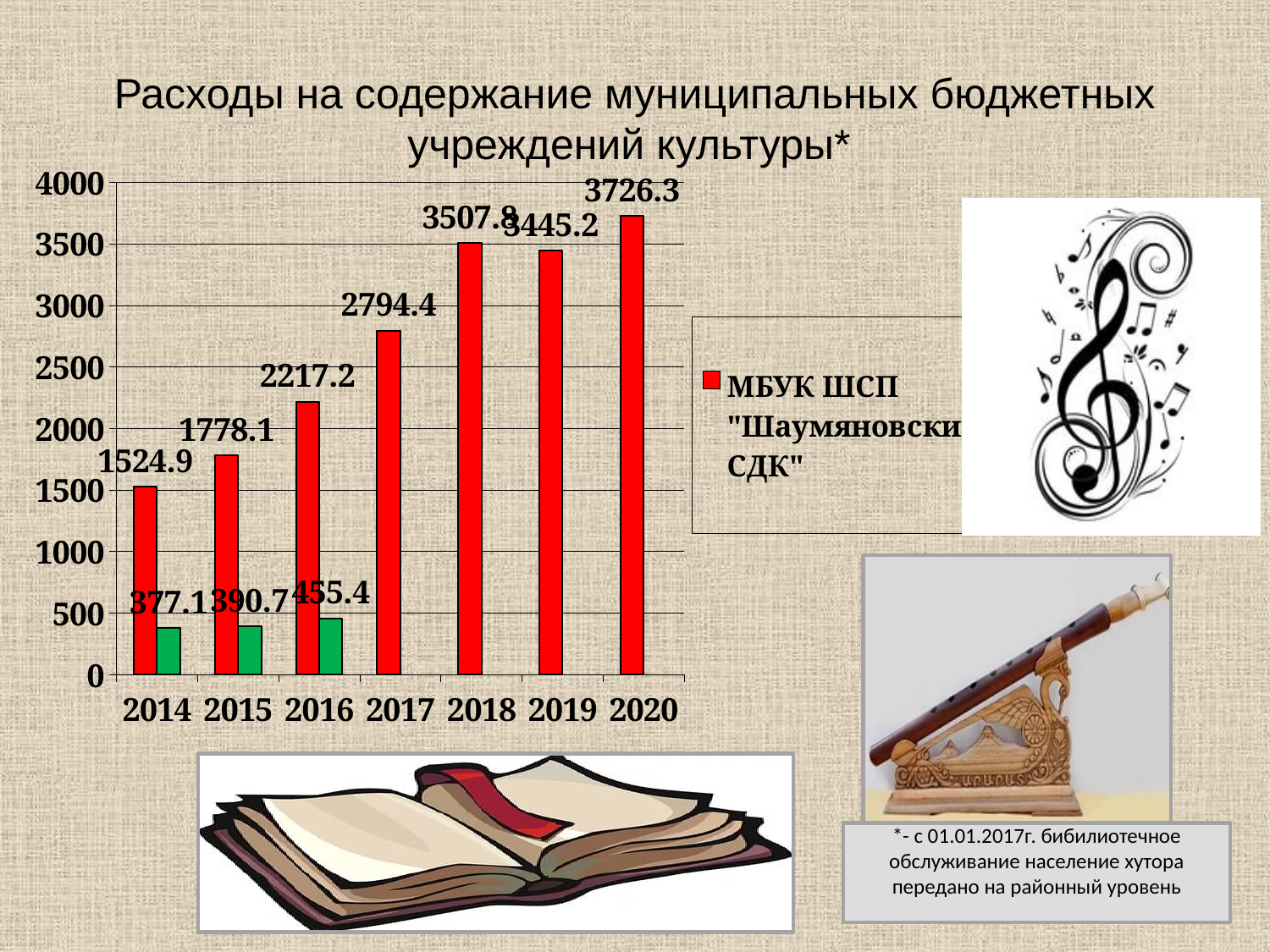
In which year is the red bar lowest? 2014 What is the difference between the red bar values for 2015 and 2014? 253.2 How many years are shown on the x axis of the chart? 7 What is the value of the red bar for 2014? 1524.9 Is the red bar value for 2017 greater or less than 2500? greater What is the difference between the red bar values for 2020 and 2019? 281.1 In which year is the red bar highest? 2020 What is the value of the green bar for 2016? 455.4 What kind of chart is shown on the slide? bar chart Do the red bar values rise or fall from 2014 to 2018? rise What is the value of the red bar for 2020? 3726.3 Which year has the larger red bar value, 2018 or 2019? 2018